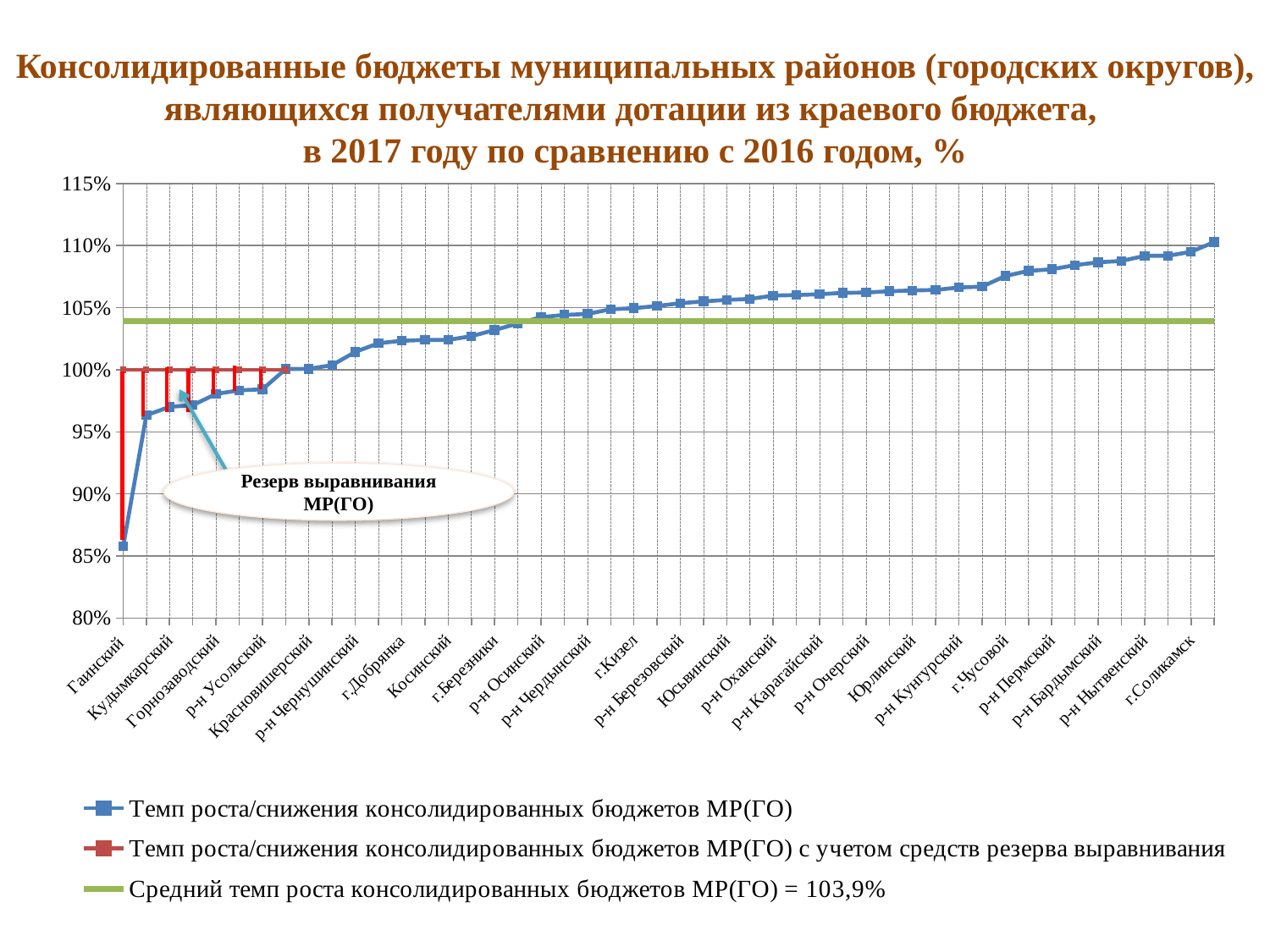
Is the value for Гаинский greater or less than 90%? less Is the value for Кудымкарский greater or less than 100%? less What kind of chart is shown on the slide? line chart Is the value for г.Соликамск greater or less than 105%? greater What text is written in the callout pointing at the red bars? Резерв выравнивания МР(ГО) How many series does the legend list? 3 Which is larger, the value for г.Соликамск or the value for Гаинский? г.Соликамск Do the values on the blue line rise or fall from left to right along the x axis? rise What is the value of the average growth rate (Средний темп роста) shown in the legend? 103,9% Which category has the lowest value on the blue line? Гаинский